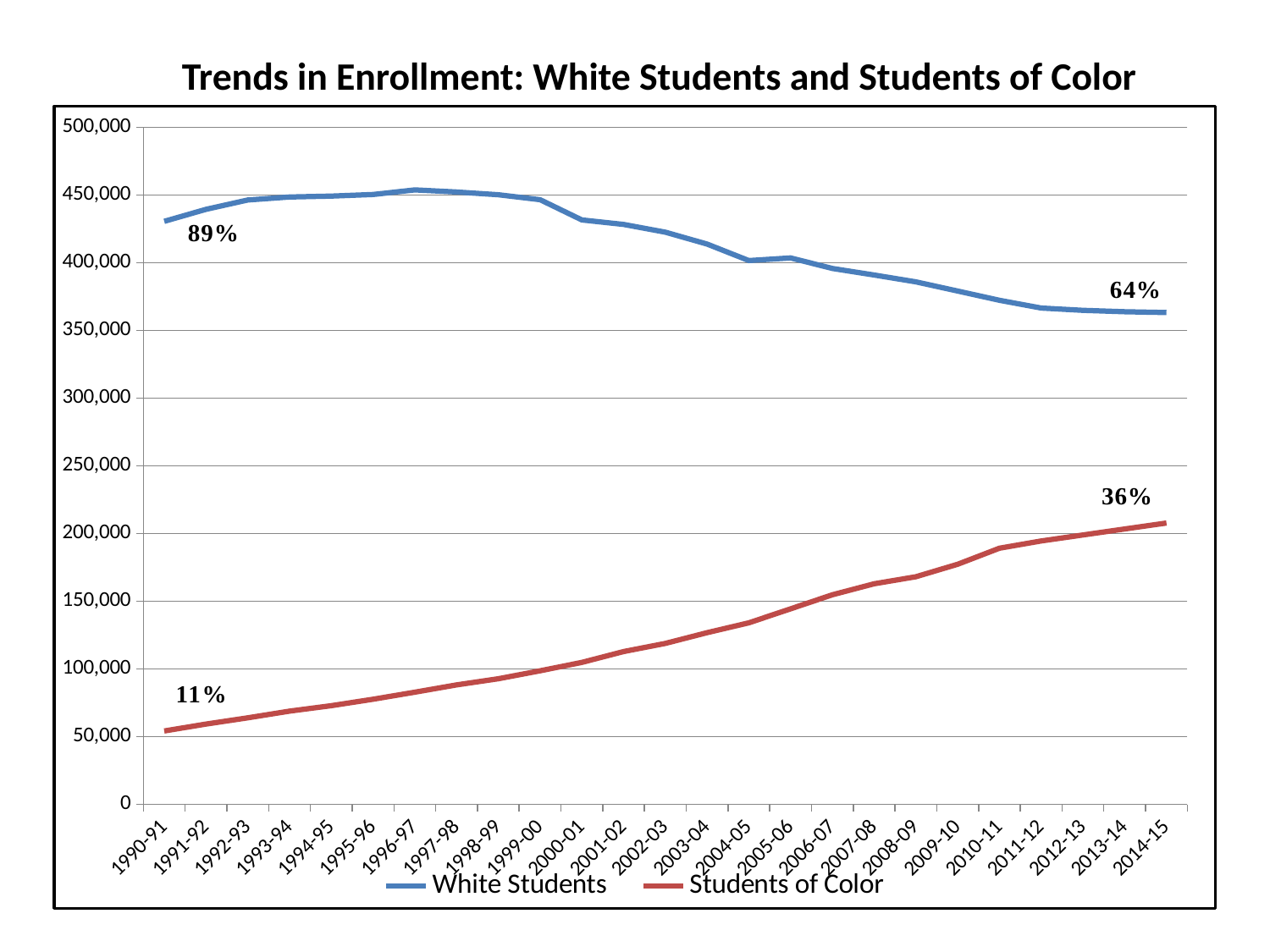
What is the title of the chart? Trends in Enrollment: White Students and Students of Color Is the value for Students of Color in 2014-15 greater or less than 200,000? greater How many series does the legend list? 2 Which series has the higher value in 2014-15, White Students or Students of Color? White Students What kind of chart is shown on the slide? line chart Does the Students of Color line rise or fall from 1990-91 to 2014-15? rise Does the White Students line rise or fall from 1999-00 to 2014-15? fall Is the value for White Students in 1990-91 greater or less than 400,000? greater Which series is drawn in red? Students of Color Is the value for White Students in 2014-15 greater or less than 400,000? less How many school years are shown along the x axis? 25